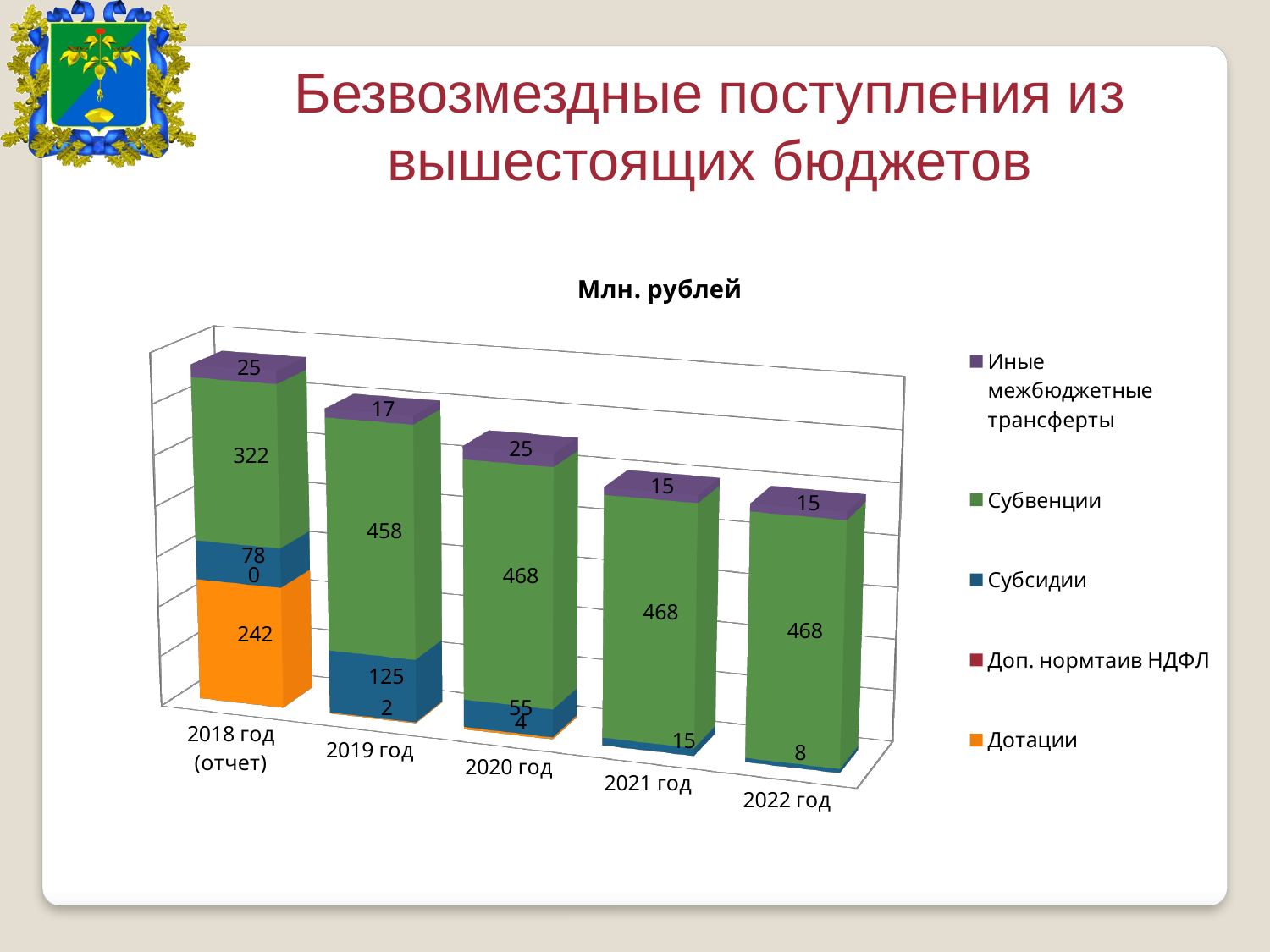
Which is larger: Субсидии in 2018 год (отчет) or in 2020 год? 2018 год (отчет) What is the value of Иные межбюджетные трансферты for 2020 год? 25 In which year is the value of Субсидии the highest? 2019 год What is the value of Субвенции for 2019 год? 458 What is the difference between Субвенции in 2019 год and in 2018 год (отчет)? 136 What is the value of Субсидии for 2019 год? 125 What is the value of Дотации for 2018 год (отчет)? 242 What is the value of Субсидии for 2022 год? 8 What kind of chart is shown on the slide? stacked bar chart How many series does the legend list? 5 What is the title of the chart? Млн. рублей How many year categories are shown on the x axis? 5